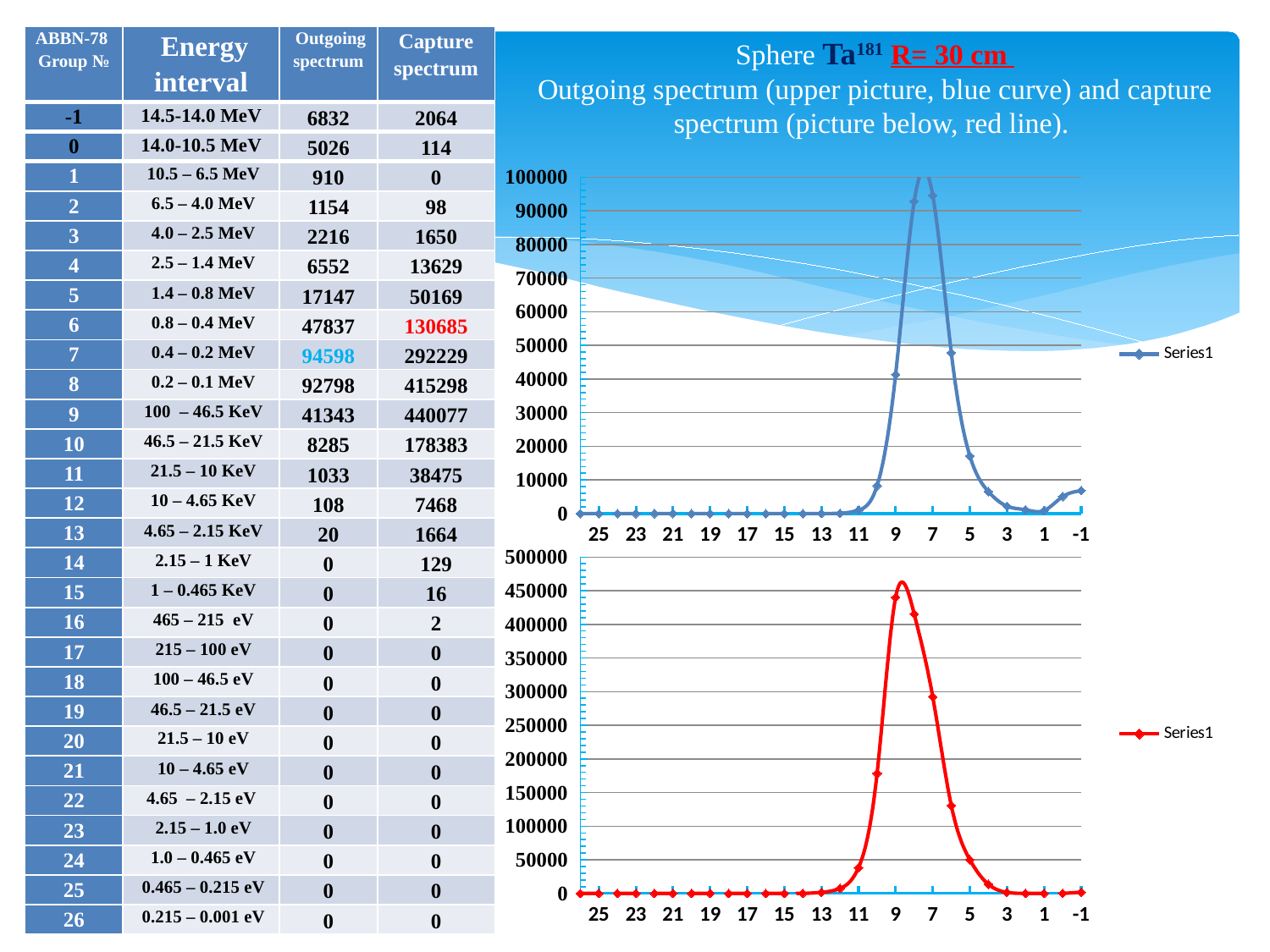
In the upper (blue) chart, is the value at x = 5 greater or less than 20000? less In the lower (red) chart, is the value at x = 10 greater or less than 200000? less What kind of chart is the lower (red) chart on the slide? line chart In the lower (red) chart, is the value at x = 6 greater or less than 100000? greater In the lower (red) chart, do the values rise or stay flat as x goes from 25 to 13? stay flat In the upper (blue) chart, how many series does the legend list? 1 In the lower (red) chart, what is the legend entry? Series1 What kind of chart is the upper (blue) chart on the slide? line chart In the lower (red) chart, what is the highest value shown on the vertical axis? 500000